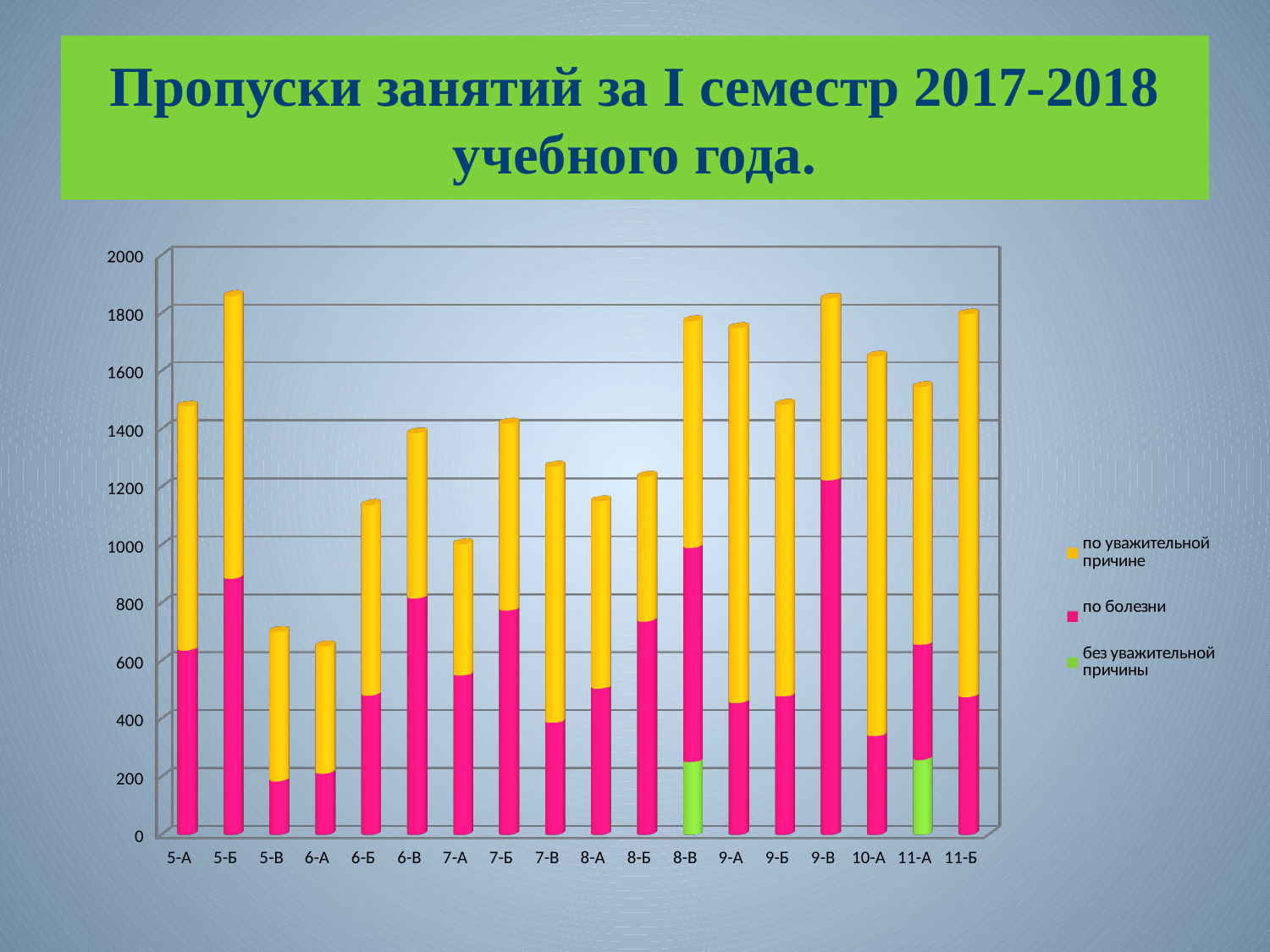
Which series is shown in yellow according to the legend? по уважительной причине Which class has the taller total bar, 8-В or 7-А? 8-В Is the total bar height for 8-В greater or less than 1600? greater How many series does the legend list? 3 Is the 'по болезни' value for 9-В greater or less than 1000? greater Which class has the taller total bar, 5-Б or 5-В? 5-Б Which series is shown in green according to the legend? без уважительной причины Is the total bar height for 7-А greater or less than 1200? less How many classes (categories) are shown along the x axis? 18 What kind of chart is shown on the slide? bar chart